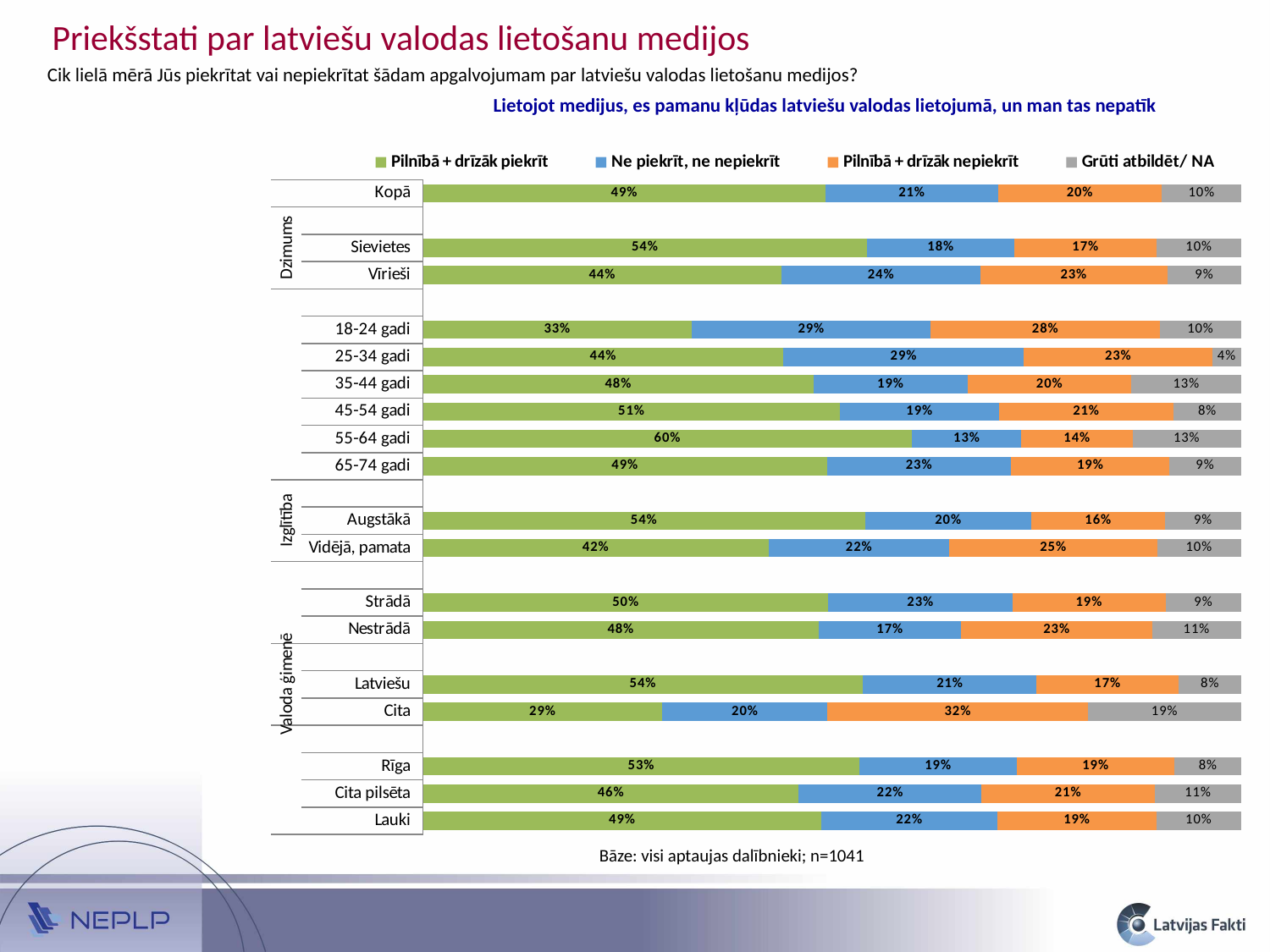
What is the value of "Ne piekrīt, ne nepiekrīt" for 18-24 gadi? 29% Which category has the highest value for "Pilnībā + drīzāk piekrīt"? 55-64 gadi What is the total of the stacked bar for Kopā? 100% What is the value of "Pilnībā + drīzāk piekrīt" for Kopā? 49% What is the value of "Pilnībā + drīzāk nepiekrīt" for Cita? 32% How many series does the legend list? 4 How many categories (rows) are plotted in the chart? 18 Which has a larger "Pilnībā + drīzāk piekrīt" value, Rīga or Lauki? Rīga Which category has the lowest value for "Grūti atbildēt/ NA"? 25-34 gadi What kind of chart is shown on the slide? Stacked bar chart Which category has the lowest value for "Pilnībā + drīzāk piekrīt"? Cita What is the difference in "Pilnībā + drīzāk piekrīt" between Sievietes and Vīrieši? 10 percentage points